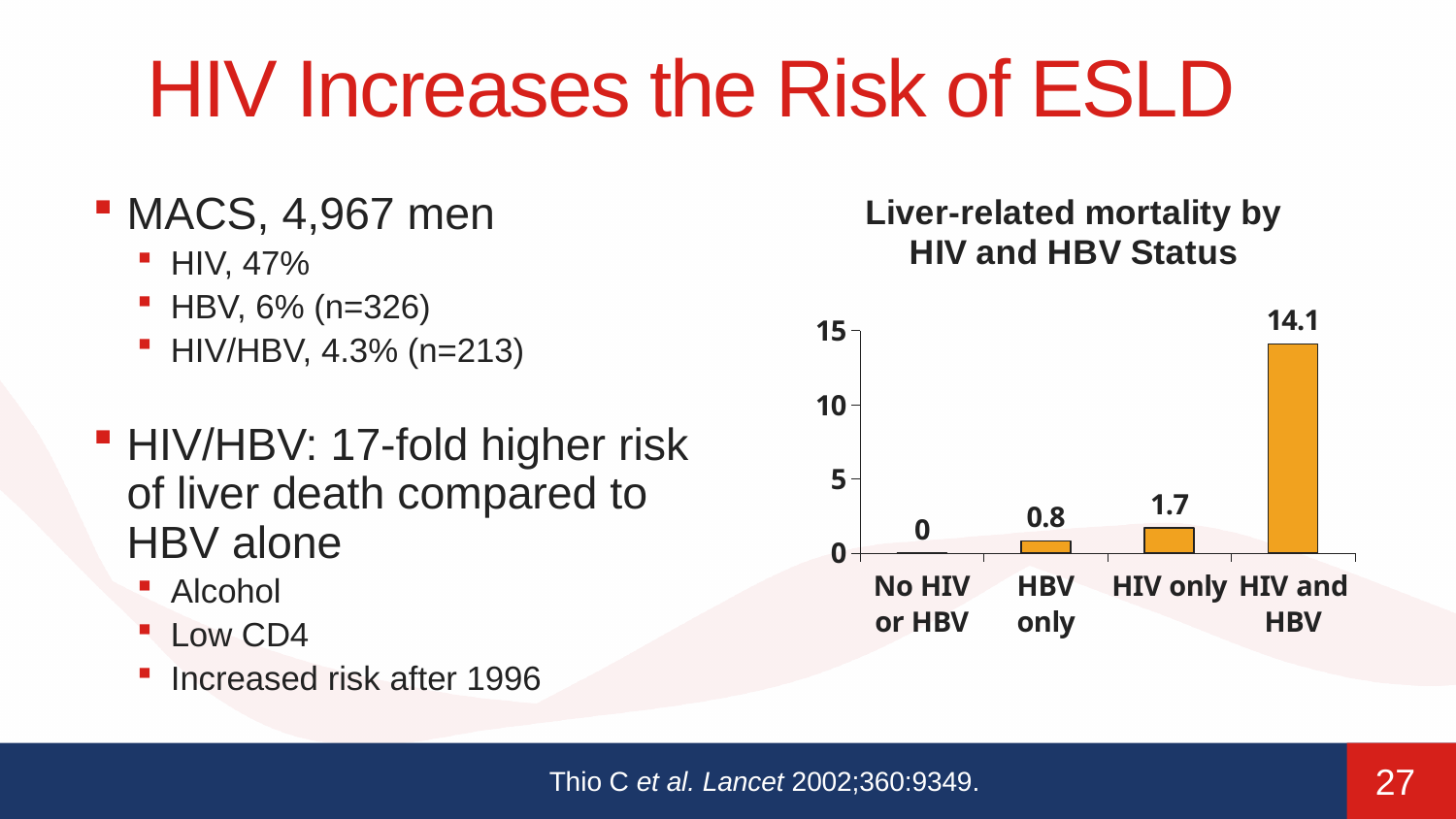
Is the value for HIV and HBV greater or less than 10? greater Which group has the lowest liver-related mortality? No HIV or HBV What is the liver-related mortality value for the HIV and HBV group? 14.1 Which is larger, the value for HIV only or the value for HBV only? HIV only What is the value shown for the HIV only group? 1.7 How many groups are shown on the x axis of the chart? 4 What is the value shown for the No HIV or HBV group? 0 What is the value shown for the HBV only group? 0.8 What kind of chart is shown on the slide? bar chart What is the difference between the HIV and HBV value and the HBV only value? 13.3 What is the title of the chart? Liver-related mortality by HIV and HBV Status Which group has the highest liver-related mortality? HIV and HBV